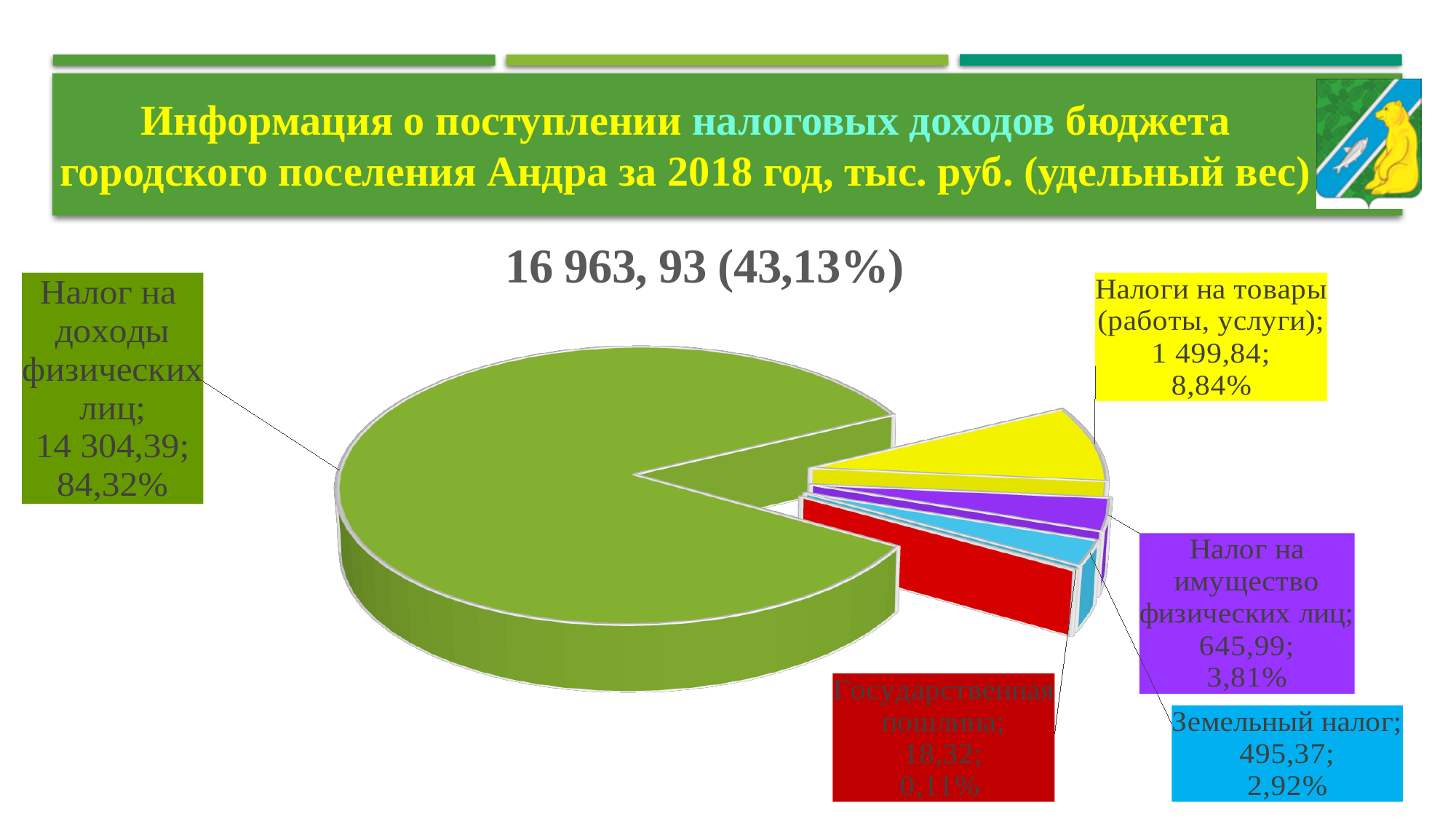
What is the value for Налог на доходы физических лиц? 14 304,39 What is the difference between the values for Налоги на товары (работы, услуги) and Налог на имущество физических лиц? 853,85 Which category has the largest slice of the pie? Налог на доходы физических лиц What is the value for Налоги на товары (работы, услуги)? 1 499,84 What share of the pie does Налог на имущество физических лиц represent? 3,81% What kind of chart is shown on the slide? Pie chart What share of the pie does Государственная пошлина represent? 0,11% Which category has the smallest slice of the pie? Государственная пошлина How many slices does the pie chart have? 5 What colour is the slice for Земельный налог? Blue What is the value for Земельный налог? 495,37 Which is larger, the value for Налог на имущество физических лиц or the value for Земельный налог? Налог на имущество физических лиц